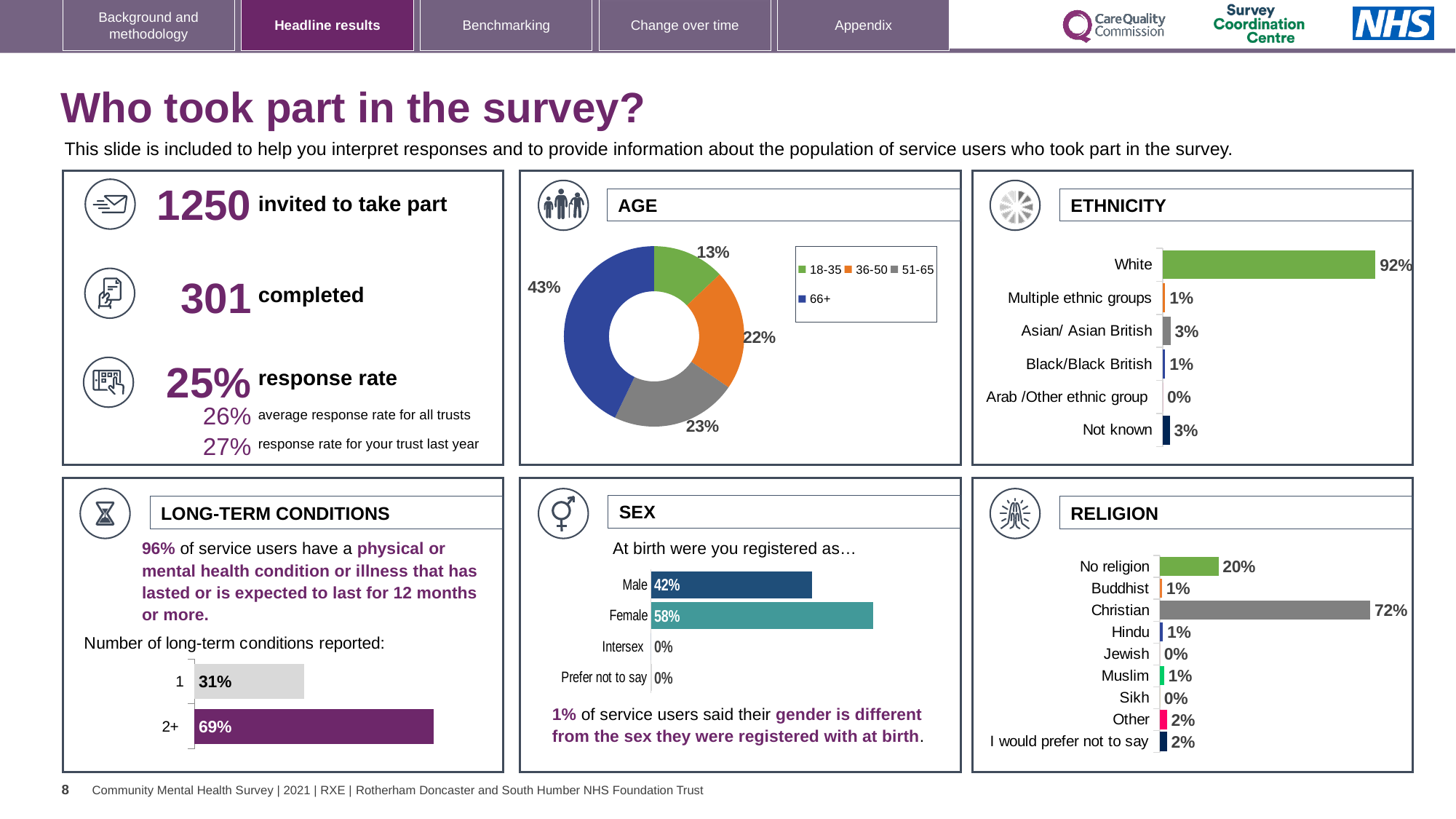
In the AGE chart, what percentage of respondents were aged 66+? 43% In the RELIGION chart, what is the value for Christian? 72% In the ETHNICITY chart, how many ethnicity categories are shown? 6 In the ETHNICITY chart, which category has the highest value? White In the AGE chart, which age group has the smallest share? 18-35 In the LONG-TERM CONDITIONS chart, what is the difference between the value for 2+ and the value for 1? 38% In the SEX chart, what percentage of service users were registered as Female at birth? 58% How many age groups does the legend of the AGE chart list? 4 What kind of chart is the AGE chart? Doughnut chart In the SEX chart, which is larger, the value for Male or the value for Female? Female In the RELIGION chart, how many religion categories are shown? 9 In the ETHNICITY chart, what is the value for Asian/ Asian British? 3%